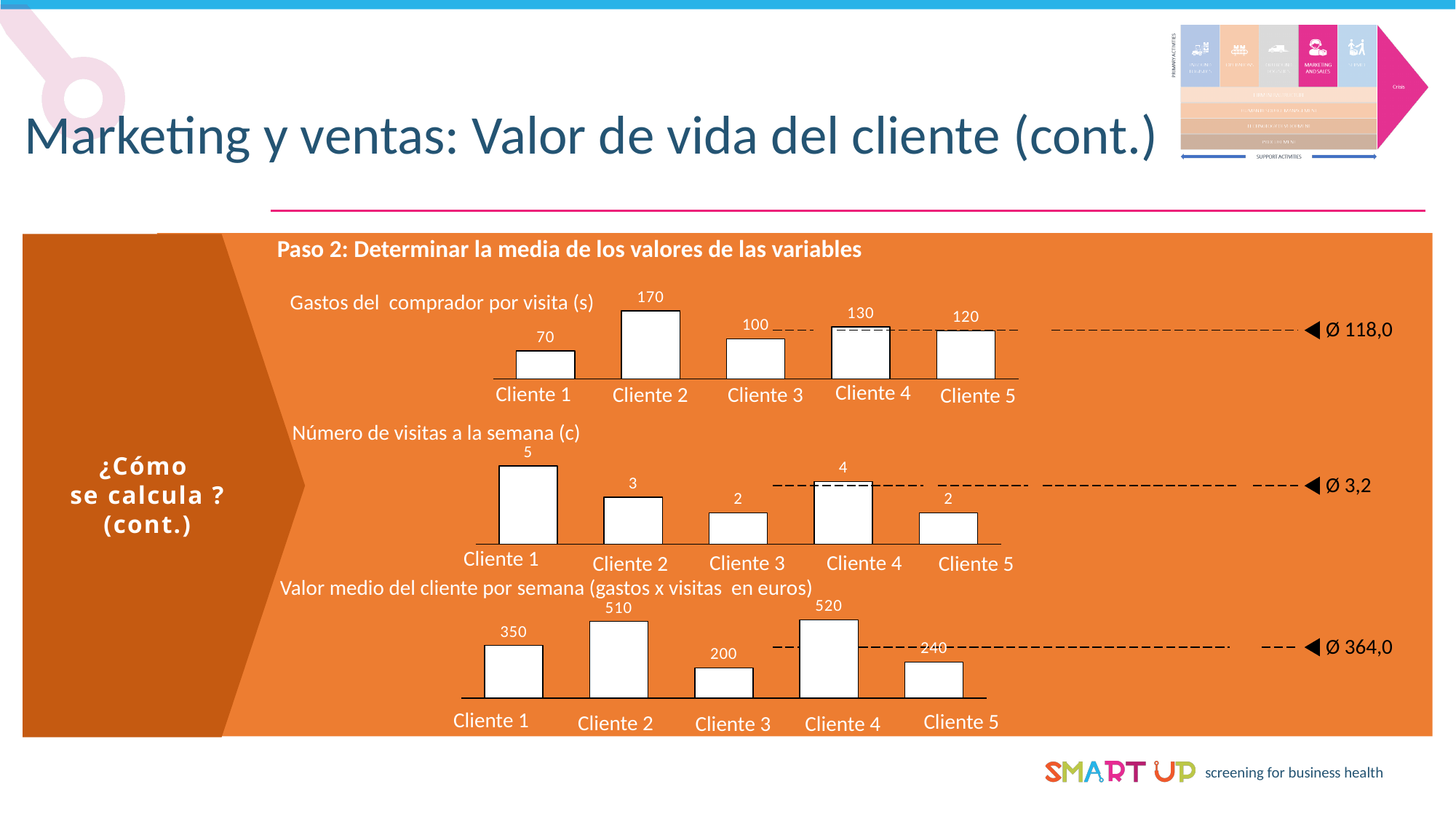
In the 'Número de visitas a la semana (c)' chart, what is the value for Cliente 4? 4 In the 'Número de visitas a la semana (c)' chart, which cliente has the highest value? Cliente 1 In the 'Gastos del comprador por visita (s)' chart, what is the difference between Cliente 4 and Cliente 3? 30 In the 'Gastos del comprador por visita (s)' chart, which cliente has the lowest value? Cliente 1 In the 'Valor medio del cliente por semana' chart, what is the difference between Cliente 2 and Cliente 1? 160 In the 'Gastos del comprador por visita (s)' chart, what is the value for Cliente 2? 170 What type of chart is used for 'Número de visitas a la semana (c)'? Bar chart In the 'Valor medio del cliente por semana' chart, which cliente has the highest value? Cliente 4 What average (Ø) value is shown next to the 'Valor medio del cliente por semana' chart? Ø 364,0 How many clientes are shown in the 'Gastos del comprador por visita (s)' chart? 5 In the 'Valor medio del cliente por semana' chart, what is the value for Cliente 3? 200 In the 'Número de visitas a la semana (c)' chart, which is larger, Cliente 2 or Cliente 5? Cliente 2